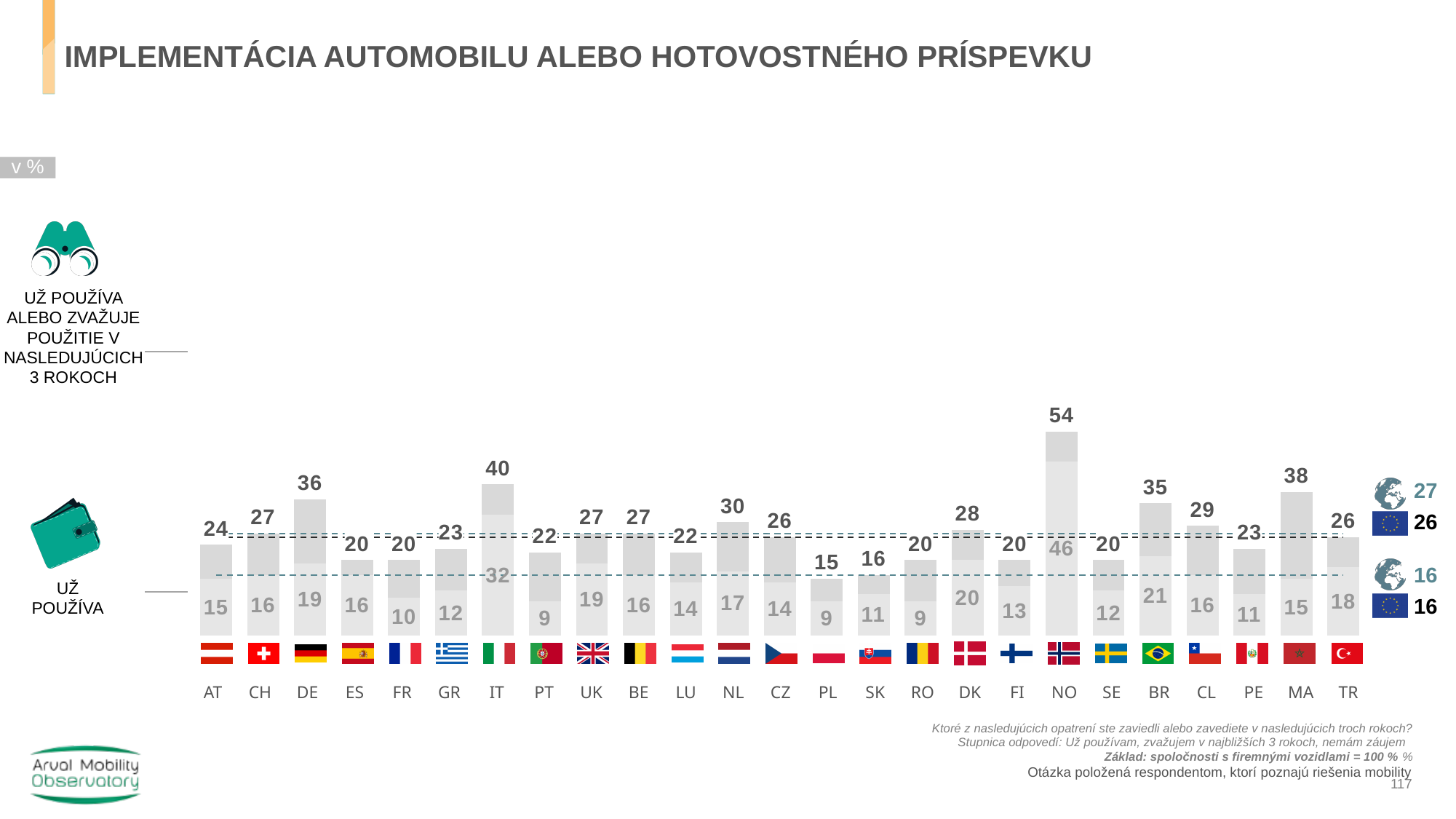
What is the difference between the 'Už používa alebo zvažuje' value and the 'Už používa' value for DE? 17 What is the 'Už používa alebo zvažuje použitie v nasledujúcich 3 rokoch' value for MA? 38 What is the EU average value shown for 'Už používa alebo zvažuje použitie v nasledujúcich 3 rokoch'? 26 What is the difference between the 'Už používa' values for NO and SE? 34 What is the 'Už používa' value for IT? 32 Which country has the highest value for 'Už používa alebo zvažuje použitie v nasledujúcich 3 rokoch'? NO How many countries are shown on the x axis of the chart? 25 What is the value for NO for 'Už používa alebo zvažuje použitie v nasledujúcich 3 rokoch'? 54 Which country has the lowest value for 'Už používa alebo zvažuje použitie v nasledujúcich 3 rokoch'? PL What type of chart is shown on the slide? bar chart What is the 'Už používa' value for FR? 10 Which is larger, the 'Už používa' value for BR or for CL? BR